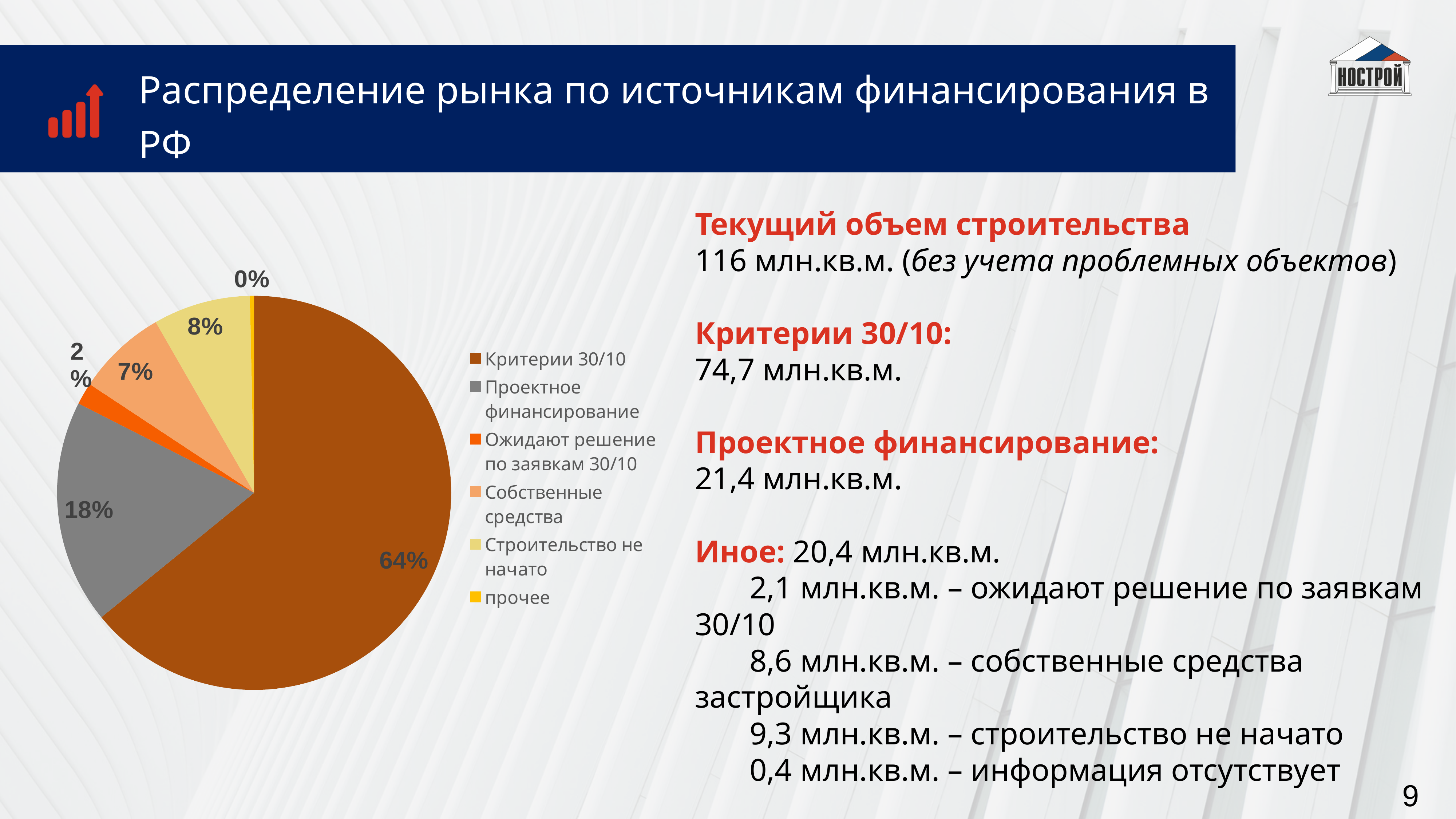
Which category has the largest slice of the pie? Критерии 30/10 What share of the pie does "Ожидают решение по заявкам 30/10" hold? 2% What share of the pie does "Собственные средства" hold? 7% What share of the pie does "Строительство не начато" hold? 8% What is the difference in percentage points between "Критерии 30/10" and "Проектное финансирование"? 46 What kind of chart is shown on the slide? Pie chart Which is larger: the slice for "Строительство не начато" or the slice for "Собственные средства"? Строительство не начато How many categories does the legend of the pie chart list? 6 Which category has the smallest slice of the pie? прочее